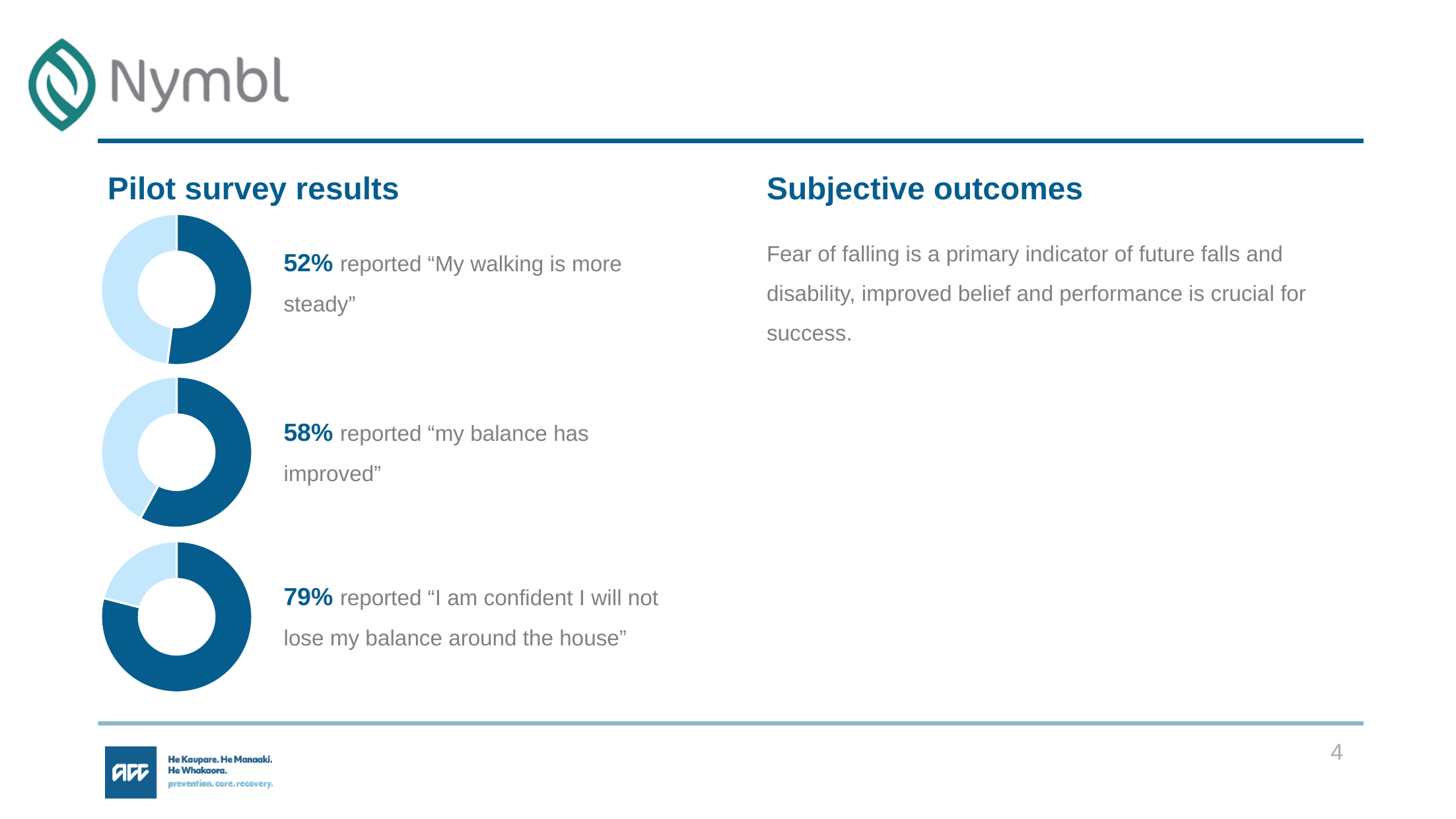
Among the three pilot survey donut charts, which statement had the highest percentage of respondents? I am confident I will not lose my balance around the house In the pilot survey donut charts, which colour is used for the segment representing the reported percentage? Dark blue Among the three pilot survey donut charts, which statement had the lowest percentage of respondents? My walking is more steady Which is larger: the percentage reporting 'my balance has improved' or the percentage reporting 'My walking is more steady'? my balance has improved What kind of chart is used to show the pilot survey results? Donut (pie) chart What is the difference in percentage points between the bottom donut chart (79%) and the top donut chart (52%)? 27 percentage points In the top donut chart under 'Pilot survey results', what percentage reported 'My walking is more steady'? 52% What is the difference in percentage points between the 'my balance has improved' result and the 'My walking is more steady' result? 6 percentage points In the middle donut chart, what percentage reported 'my balance has improved'? 58% How many donut charts are shown under 'Pilot survey results'? 3 In the bottom donut chart, what share of the ring does the dark blue segment represent? 79% In the bottom donut chart, what percentage reported 'I am confident I will not lose my balance around the house'? 79%